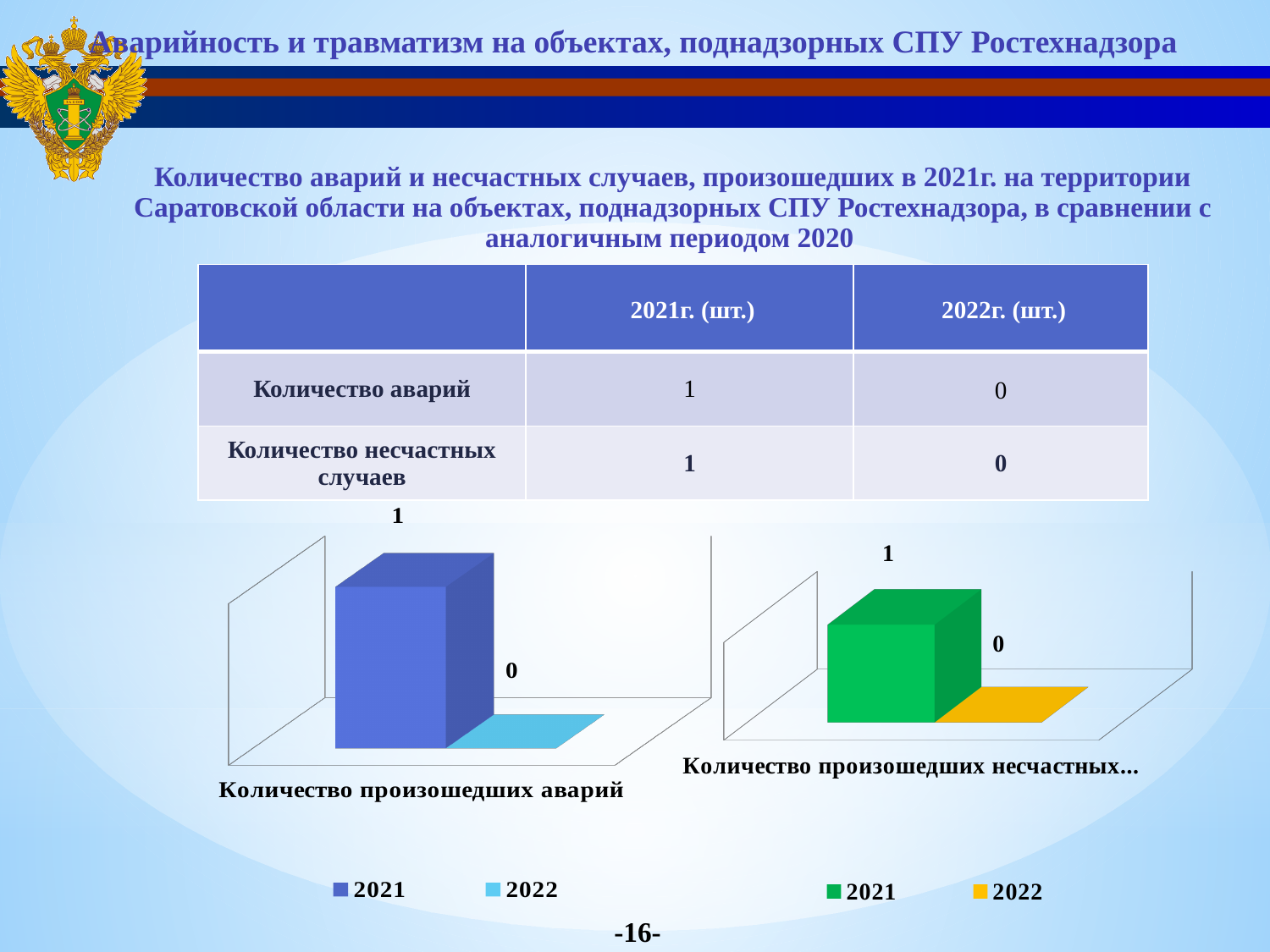
What kind of chart is the right chart (Количество произошедших несчастных...)? bar chart In the right chart (Количество произошедших несчастных...), is the value for 2021 larger or smaller than the value for 2022? larger In the left chart (Количество произошедших аварий), which year has the higher value? 2021 In the right chart (Количество произошедших несчастных...), which year has the lower value? 2022 In the left chart (Количество произошедших аварий), what is the difference between the 2021 and 2022 values? 1 In the right chart (Количество произошедших несчастных...), do the values rise or fall from 2021 to 2022? fall In the left chart (Количество произошедших аварий), what is the value for 2021? 1 How many series does the legend of the left chart (Количество произошедших аварий) list? 2 In the right chart (Количество произошедших несчастных...), what colour is the 2021 bar? green In the right chart (Количество произошедших несчастных...), what is the value for 2021? 1 In the left chart (Количество произошедших аварий), what is the value for 2022? 0 In the right chart (Количество произошедших несчастных...), what is the value for 2022? 0